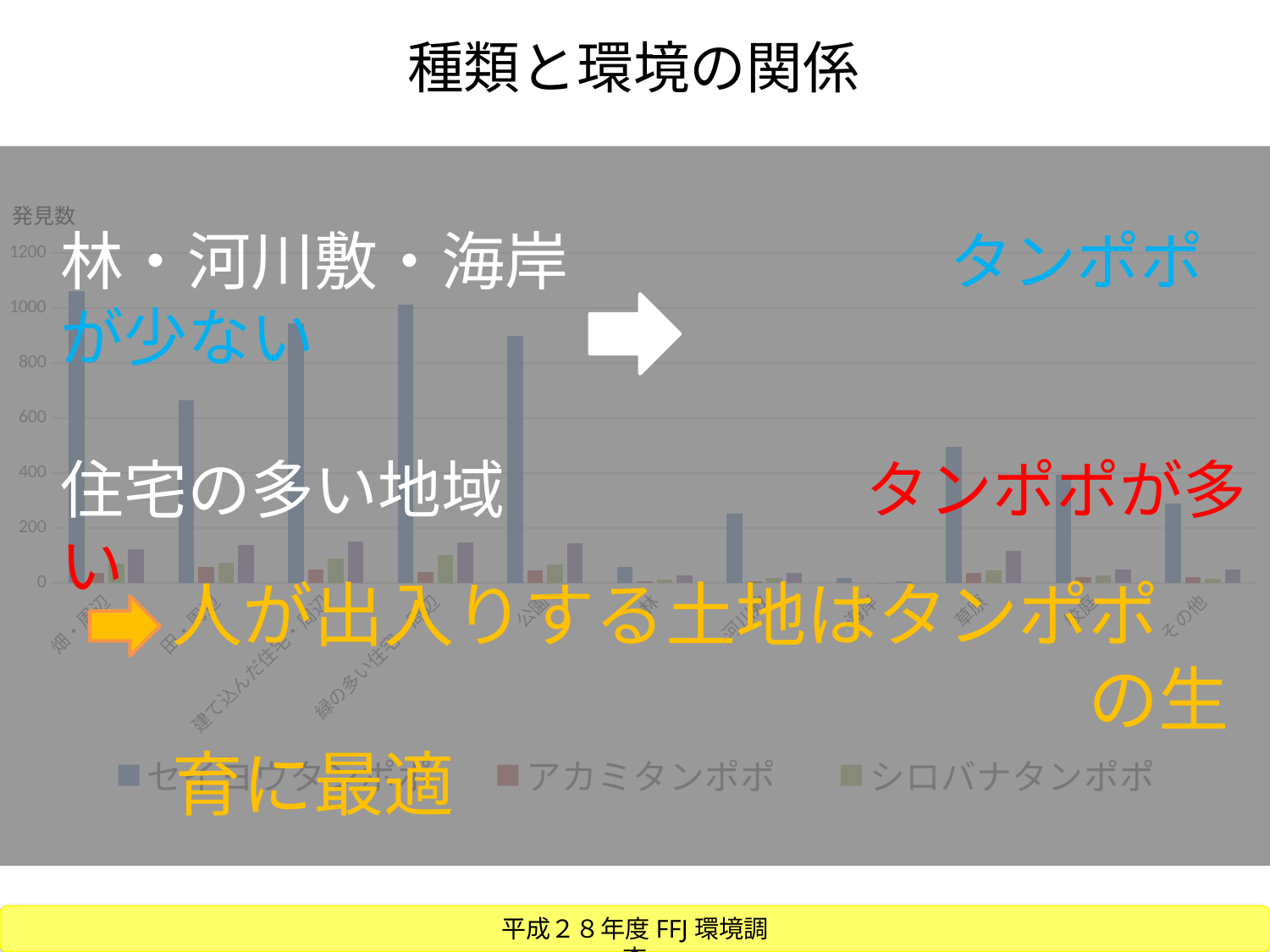
What are the three series listed in the legend? セイヨウタンポポ, アカミタンポポ, シロバナタンポポ Is the value for セイヨウタンポポ at 草原 greater or less than 400? greater Is the value for セイヨウタンポポ at 林 greater or less than 200? less How many series does the legend list? 3 What kind of chart is shown on the slide? bar chart Is the value for セイヨウタンポポ at その他 greater or less than 200? greater Which is larger for セイヨウタンポポ: 公園 or 林? 公園 Which series has the tallest bars across the categories? セイヨウタンポポ What is the label on the vertical axis of the chart? 発見数 Which is larger for セイヨウタンポポ: 草原 or その他? 草原